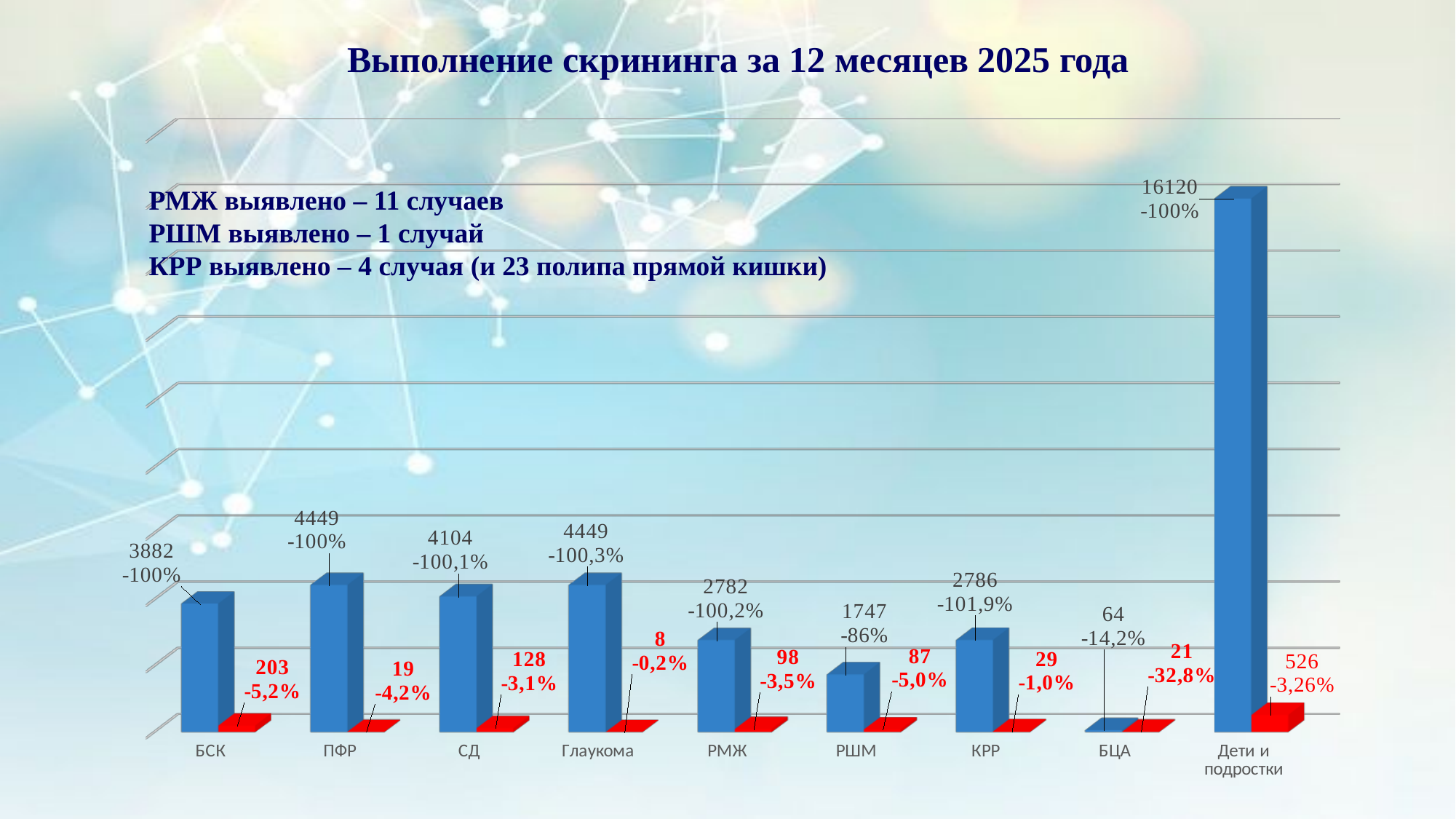
What is the value of the blue bar for Дети и подростки? 16120 What type of chart is shown on the slide? bar chart Which category has the lowest blue bar? БЦА How many categories are shown on the x axis of the chart? 9 What is the title of the chart on the slide? Выполнение скрининга за 12 месяцев 2025 года What percentage is shown next to the blue bar for БЦА? -14,2% Which category has the lowest red bar value? Глаукома Which category has the highest blue bar? Дети и подростки What is the difference between the blue bar values for ПФР and СД? 345 What is the value of the blue bar for БСК? 3882 What is the value of the red bar for СД? 128 Which is larger, the blue bar for РМЖ or the blue bar for РШМ? РМЖ